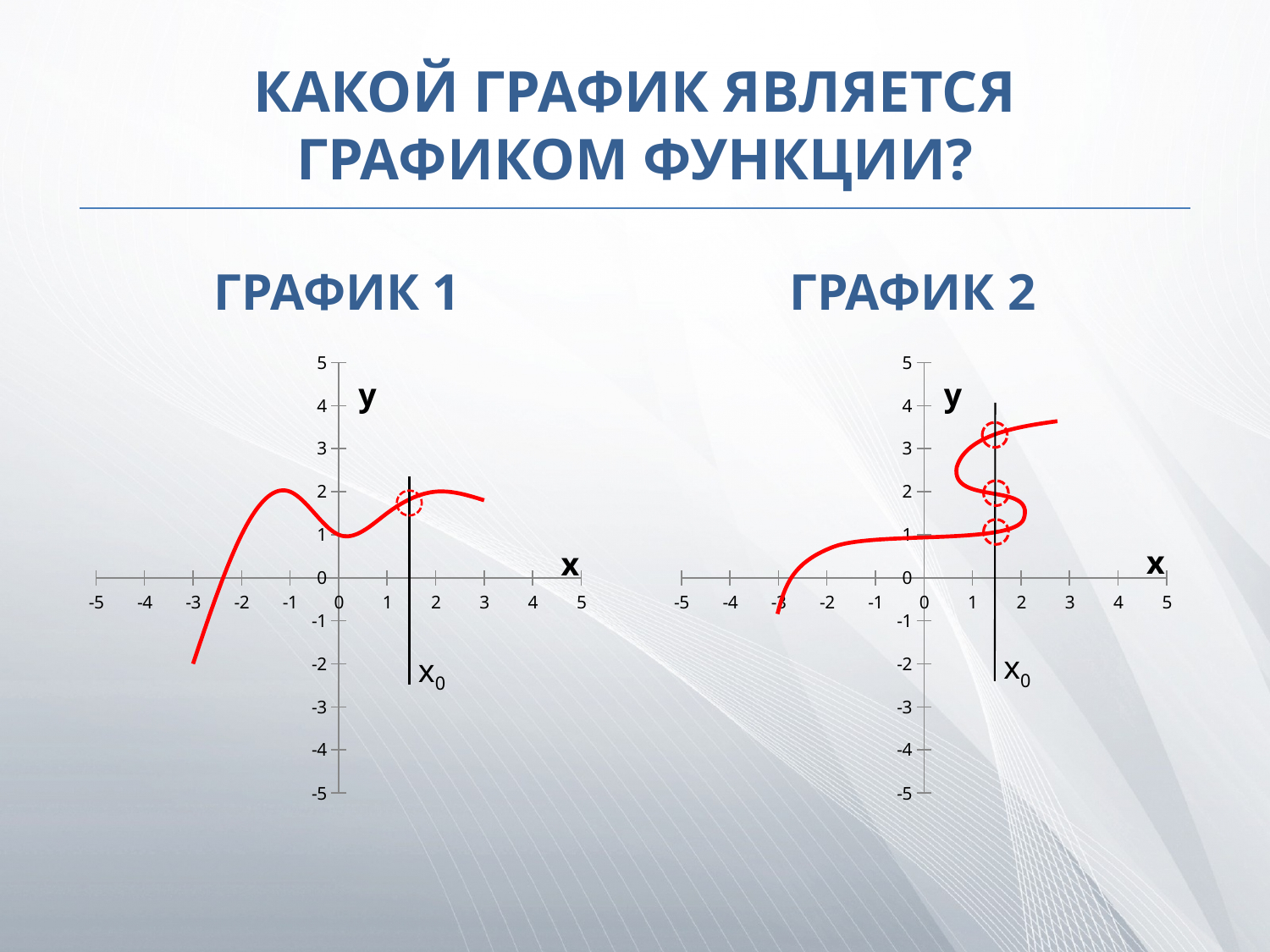
In the chart titled ГРАФИК 1, what is the highest value labelled on the y axis? 5 What kind of chart is shown under the heading ГРАФИК 1? line chart In the chart titled ГРАФИК 1, is the value of the curve at x = 3 greater or less than 1? greater How many charts are shown on the slide? 2 In the chart titled ГРАФИК 1, does the curve rise or fall as x goes from -3 to -1? rise In the chart titled ГРАФИК 2, is the value of the curve at x = 2.5 greater or less than 3? greater In the chart titled ГРАФИК 1, does the curve rise or fall as x goes from -1 to 0? fall In the chart titled ГРАФИК 1, how many dashed circles mark where the curve crosses the vertical line x0? 1 What kind of chart is shown under the heading ГРАФИК 2? line chart In the chart titled ГРАФИК 2, what is the lowest value labelled on the x axis? -5 In the chart titled ГРАФИК 1, is the value of the curve at x = -3 greater or less than 0? less In the chart titled ГРАФИК 2, how many dashed circles mark where the curve crosses the vertical line x0? 3